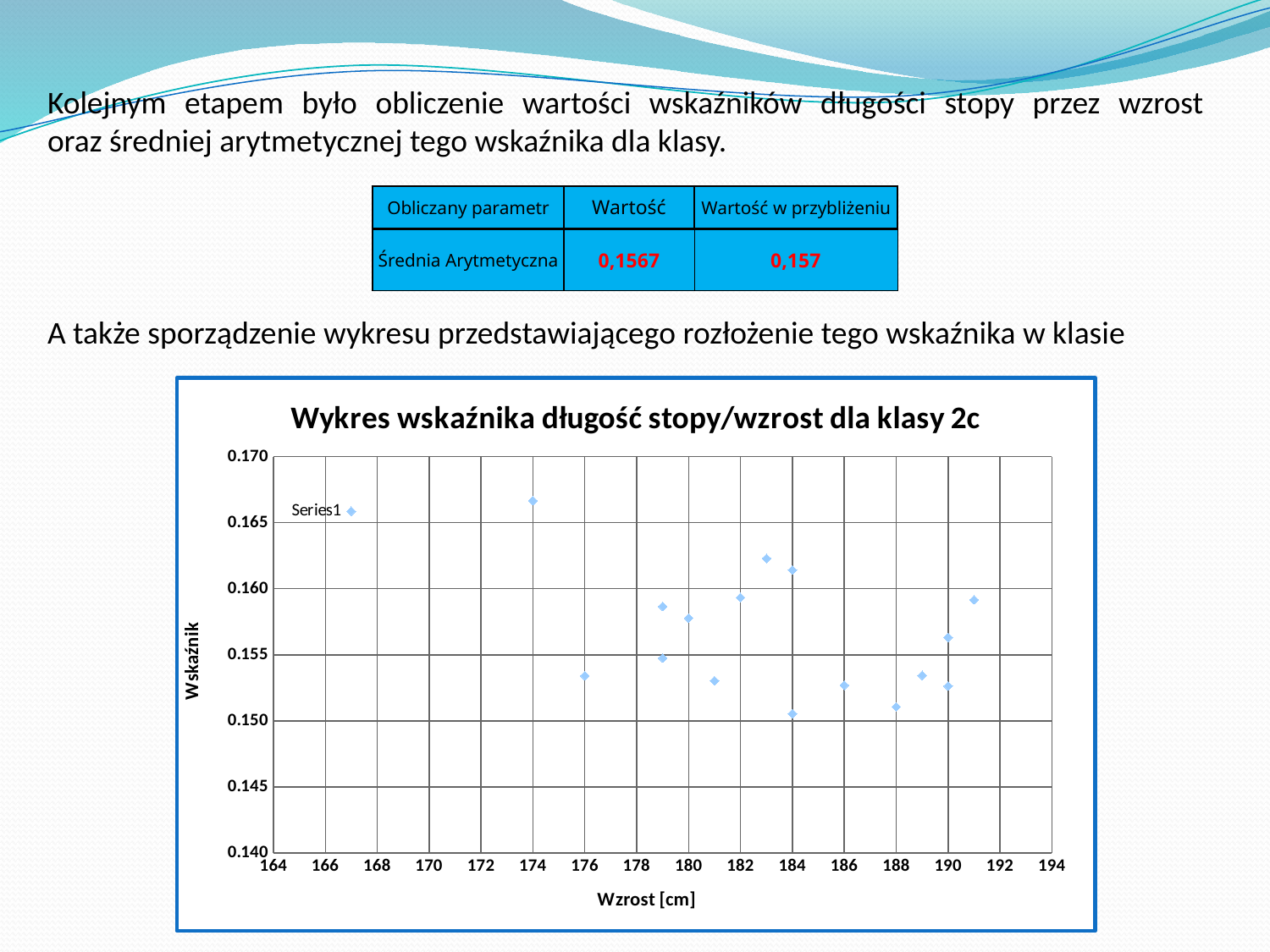
How many series does the chart legend list? 1 Which has the larger index value: the point at 174 cm or the point at 176 cm? 174 cm Is the value for the point at 176 cm greater or less than 0.155? less Which has the larger index value: the point at 183 cm or the point at 186 cm? 183 cm What kind of chart is shown on the slide? scatter chart What is the title of the chart? Wykres wskaźnika długość stopy/wzrost dla klasy 2c Is the value for the point at 183 cm greater or less than 0.160? greater Is the value for the point at 188 cm greater or less than 0.155? less At which height (Wzrost) is the highest value of the index plotted? 174 What is the label of the x axis of the chart? Wzrost [cm]